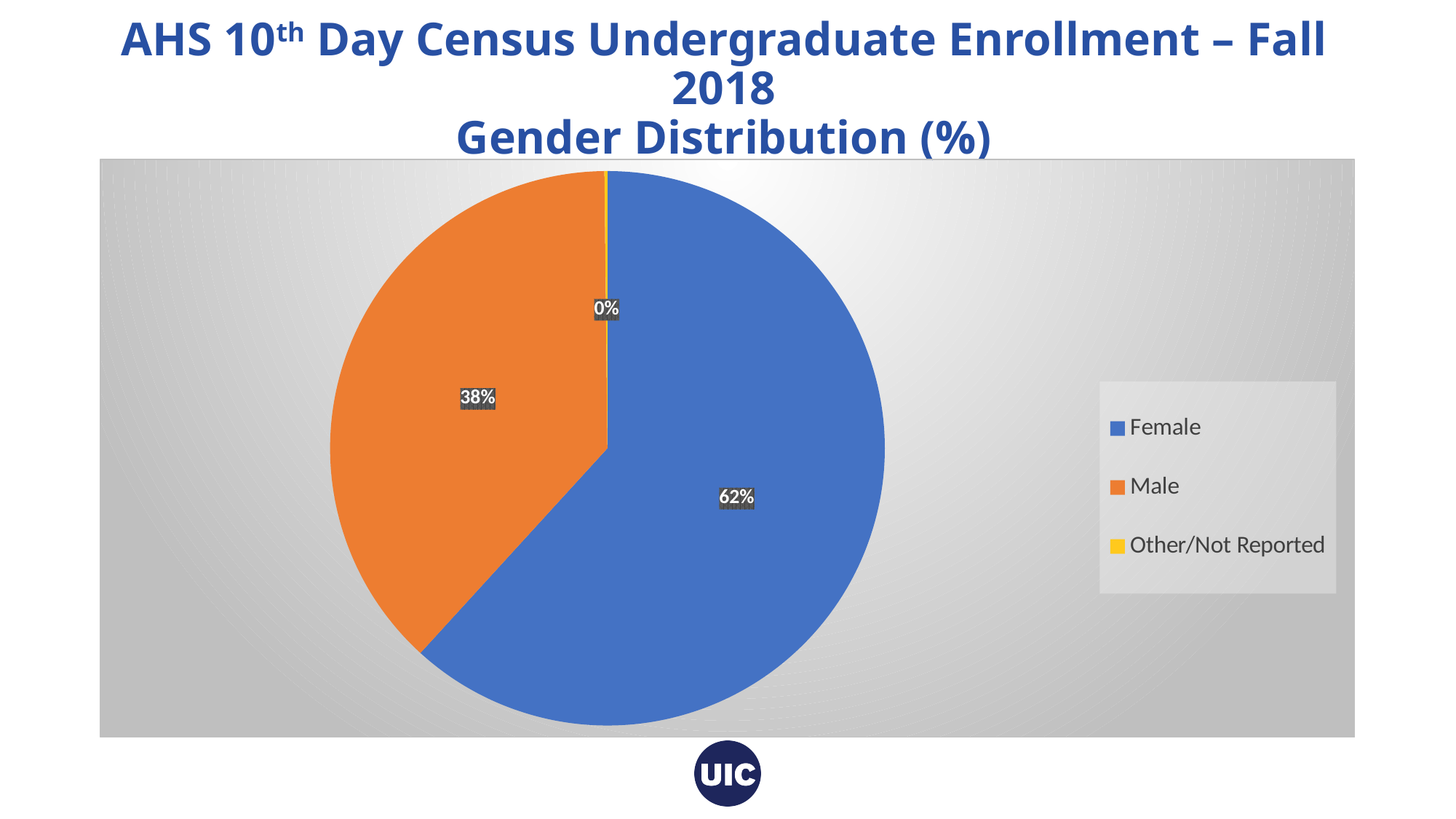
What kind of chart is shown on the slide? Pie chart What percentage of undergraduate enrollment is Female? 62% Which category has the smallest share of the pie? Other/Not Reported What colour represents Male in the pie chart? Orange Which is larger, the Female share or the Male share? Female What percentage is shown for Other/Not Reported? 0% What is the title of the chart? AHS 10th Day Census Undergraduate Enrollment – Fall 2018 Gender Distribution (%) How many categories does the legend list? 3 What is the difference in percentage points between the Female and Male shares? 24 What percentage of undergraduate enrollment is Male? 38% Which category has the largest share of the pie? Female